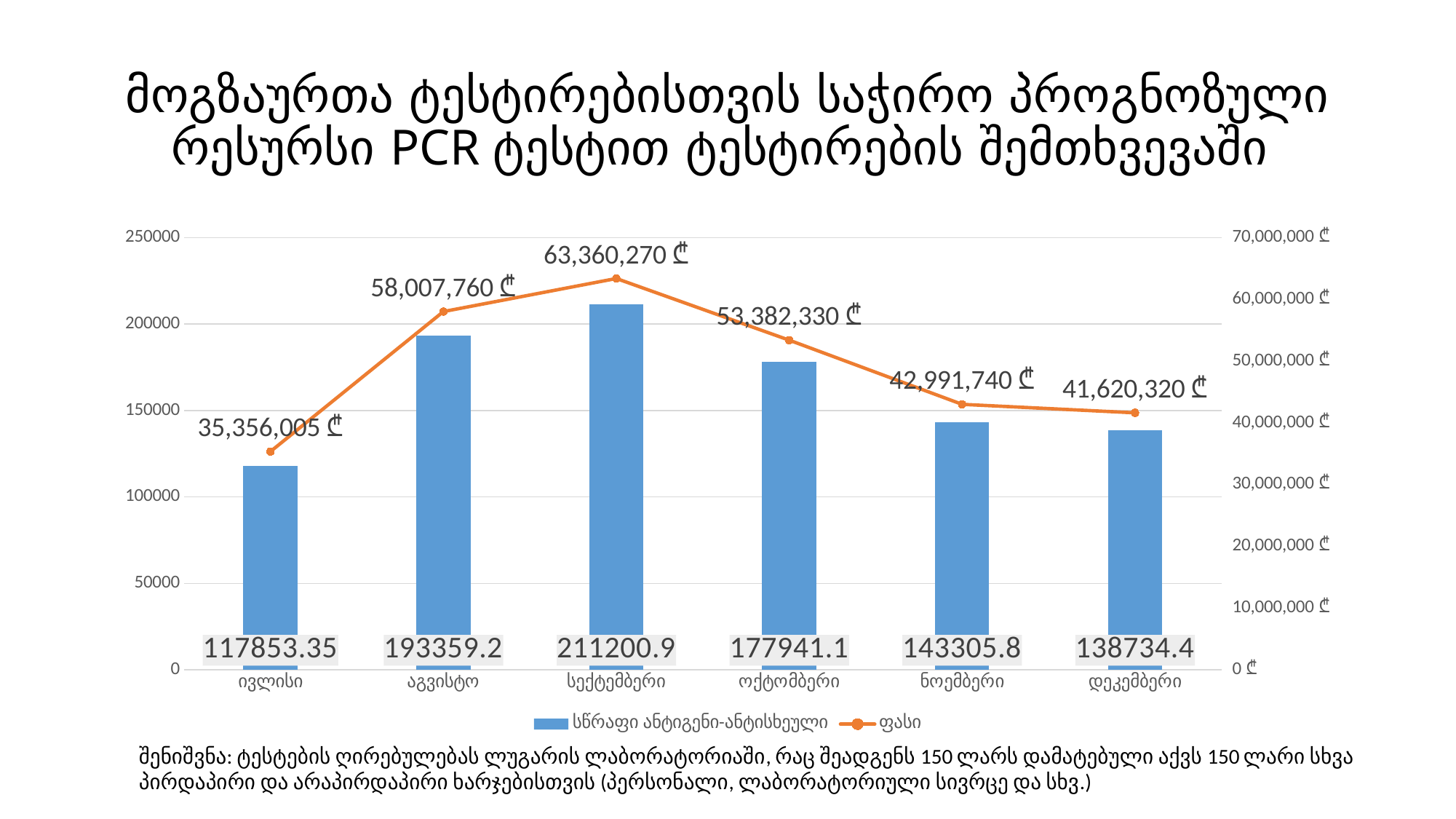
What kind of chart is shown on the slide? Combined bar and line chart How many months are shown on the x axis? 6 What is the ფასი value shown for ნოემბერი? 42,991,740 ₾ Which is larger, the ფასი value for ოქტომბერი or for აგვისტო? აგვისტო Which month has the highest სწრაფი ანტიგენი-ანტისხეული bar? სექტემბერი What is the value of the სწრაფი ანტიგენი-ანტისხეული bar for სექტემბერი? 211200.9 From სექტემბერი to დეკემბერი, do the ფასი values rise or fall? Fall How many series does the legend list? 2 What is the ფასი value shown for ივლისი? 35,356,005 ₾ What is the difference between the სწრაფი ანტიგენი-ანტისხეული values for სექტემბერი and აგვისტო? 17841.7 Which month has the lowest ფასი value? ივლისი What is the difference between the ფასი values for ნოემბერი and დეკემბერი? 1,371,420 ₾